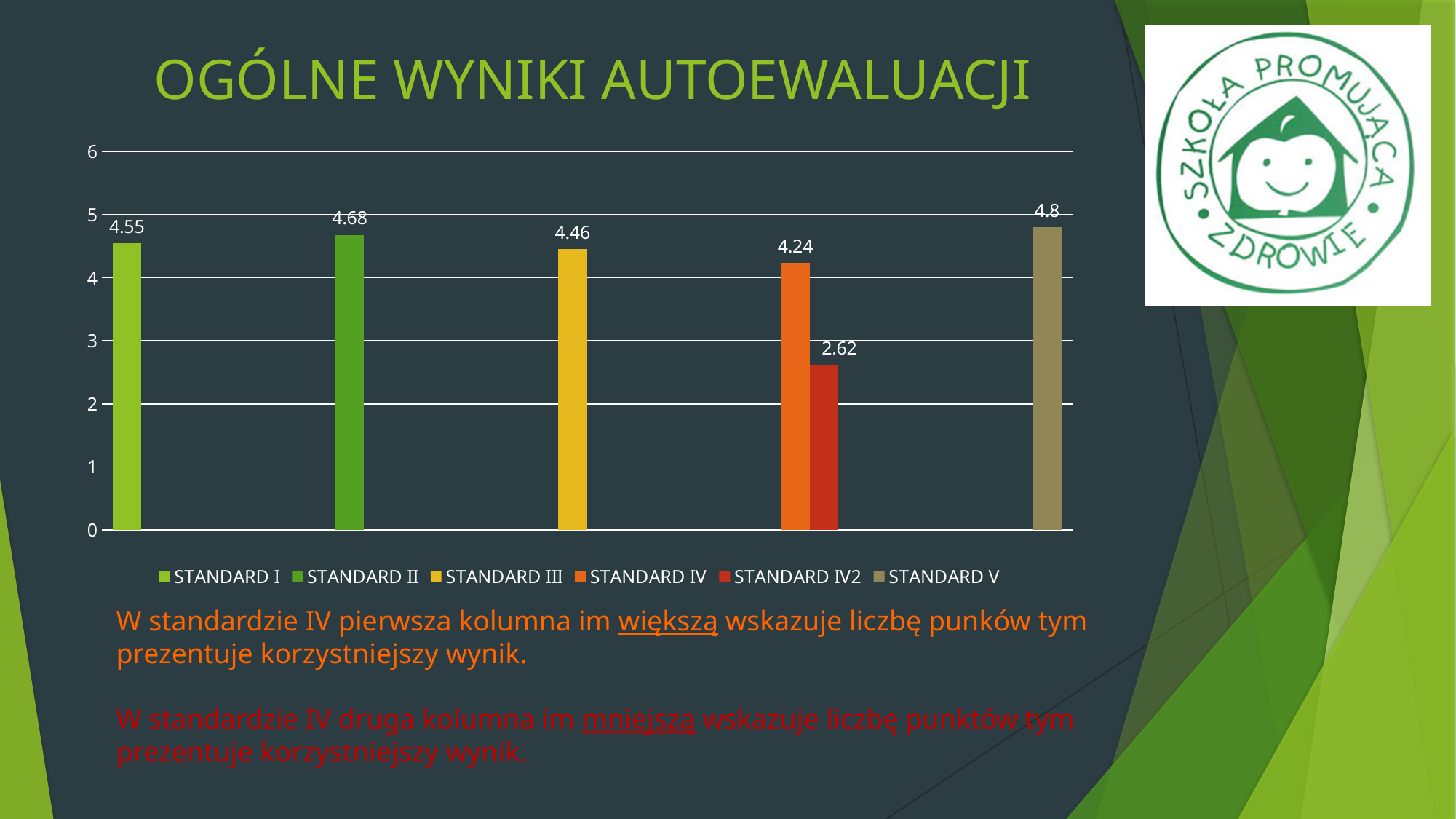
How many series does the legend list? 6 Is the value for STANDARD IV2 greater or less than 3? less What is the value for STANDARD I? 4.55 Which is larger, the value for STANDARD I or the value for STANDARD IV? STANDARD I What is the value for STANDARD IV2? 2.62 What kind of chart is shown on the slide? bar chart What is the value for STANDARD V? 4.8 What is the title of the chart? OGÓLNE WYNIKI AUTOEWALUACJI What is the difference between the values for STANDARD IV and STANDARD IV2? 1.62 What is the difference between the values for STANDARD II and STANDARD III? 0.22 Which series has the highest value? STANDARD V Which series has the lowest value? STANDARD IV2